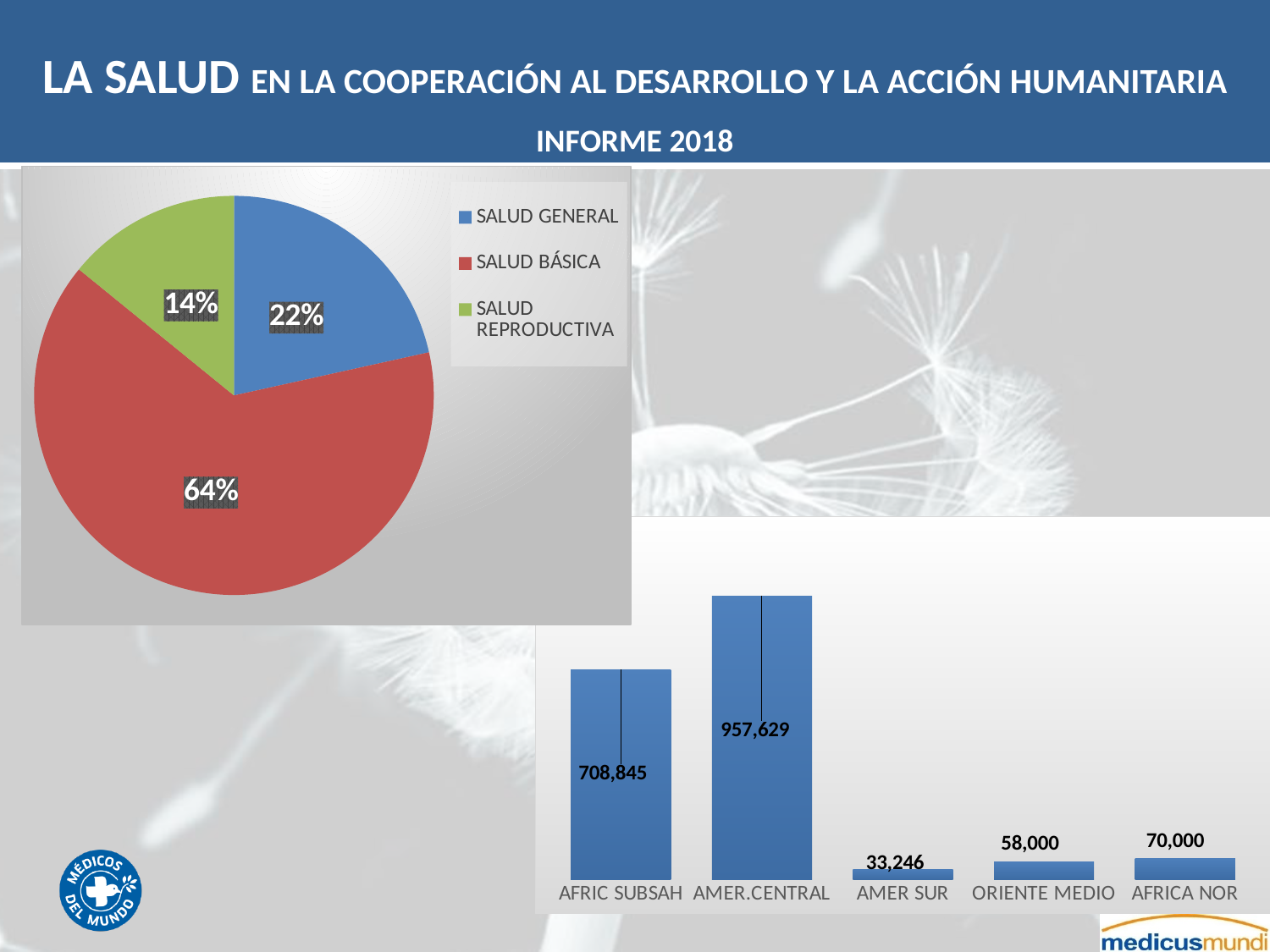
In the bar chart at the bottom right, what is the value for AMER.CENTRAL? 957,629 In the pie chart on the left, what share does SALUD REPRODUCTIVA have? 14% In the bar chart at the bottom right, how many categories are shown? 5 In the pie chart on the left, which category has the smallest slice? SALUD REPRODUCTIVA In the pie chart on the left, how many categories does the legend list? 3 In the bar chart at the bottom right, what is the value for AMER SUR? 33,246 In the pie chart on the left, what share does SALUD BÁSICA have? 64% In the pie chart on the left, what colour is the SALUD BÁSICA slice? Red In the bar chart at the bottom right, which category has the highest value? AMER.CENTRAL In the pie chart on the left, what share does SALUD GENERAL have? 22% In the pie chart on the left, which category has the largest slice? SALUD BÁSICA In the bar chart at the bottom right, what is the difference between AMER.CENTRAL and AFRIC SUBSAH? 248,784